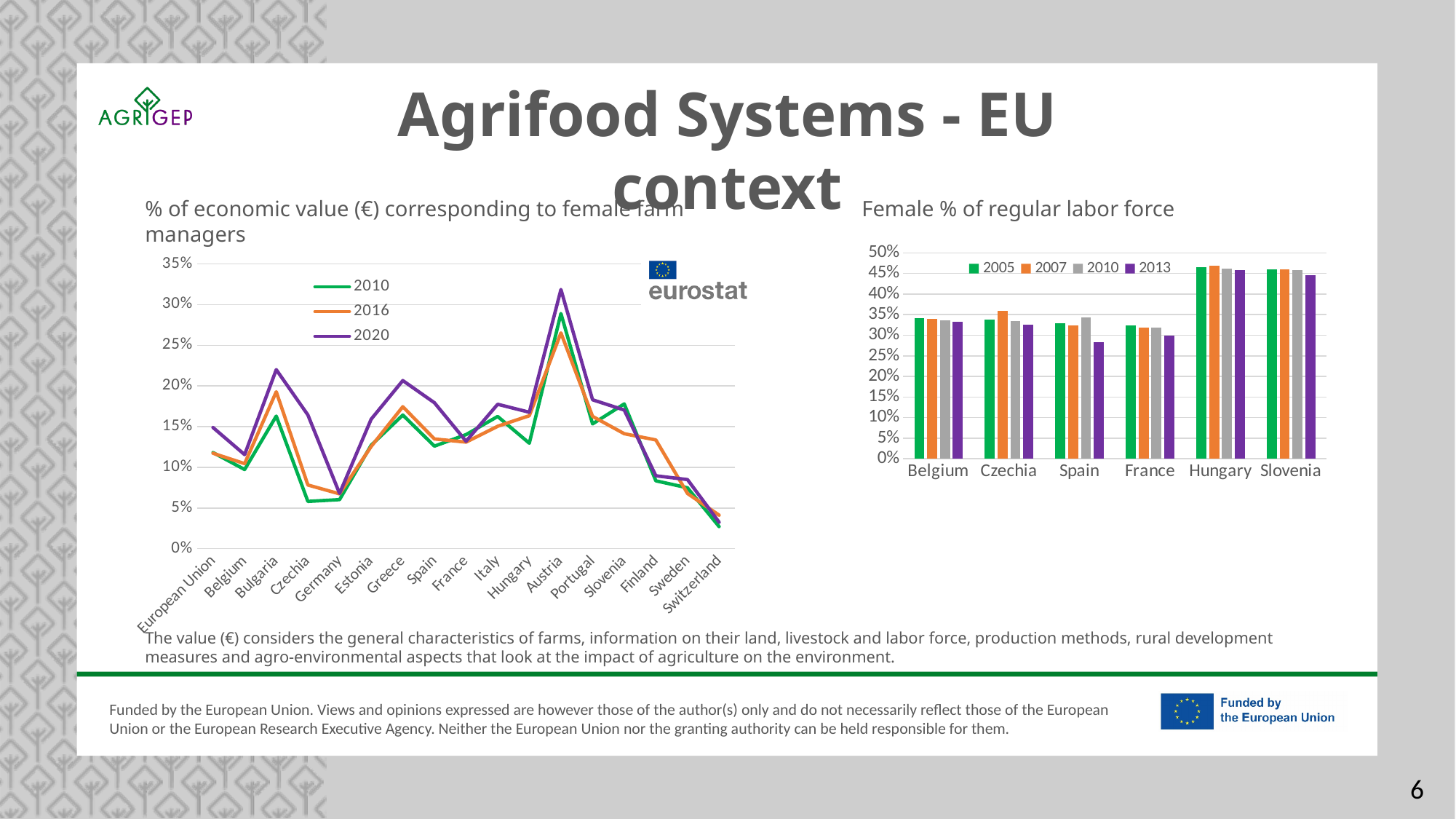
In the chart '% of economic value (€) corresponding to female farm managers', is the value for Bulgaria in 2020 greater or less than 20%? greater What kind of chart is '% of economic value (€) corresponding to female farm managers'? line chart In the chart '% of economic value (€) corresponding to female farm managers', which country has the lowest value in 2020? Switzerland In the chart '% of economic value (€) corresponding to female farm managers', how many countries/regions are shown on the x axis? 17 In the chart '% of economic value (€) corresponding to female farm managers', is the value for Czechia in 2010 greater or less than 10%? less In the chart '% of economic value (€) corresponding to female farm managers', how many series does the legend list? 3 In the chart 'Female % of regular labor force', which is larger for Czechia: the 2007 value or the 2013 value? 2007 In the chart 'Female % of regular labor force', is the value for Spain in 2013 greater or less than 30%? less In the chart '% of economic value (€) corresponding to female farm managers', which country has the highest value in 2020? Austria In the chart 'Female % of regular labor force', which country has the highest values? Hungary In the chart 'Female % of regular labor force', how many series does the legend list? 4